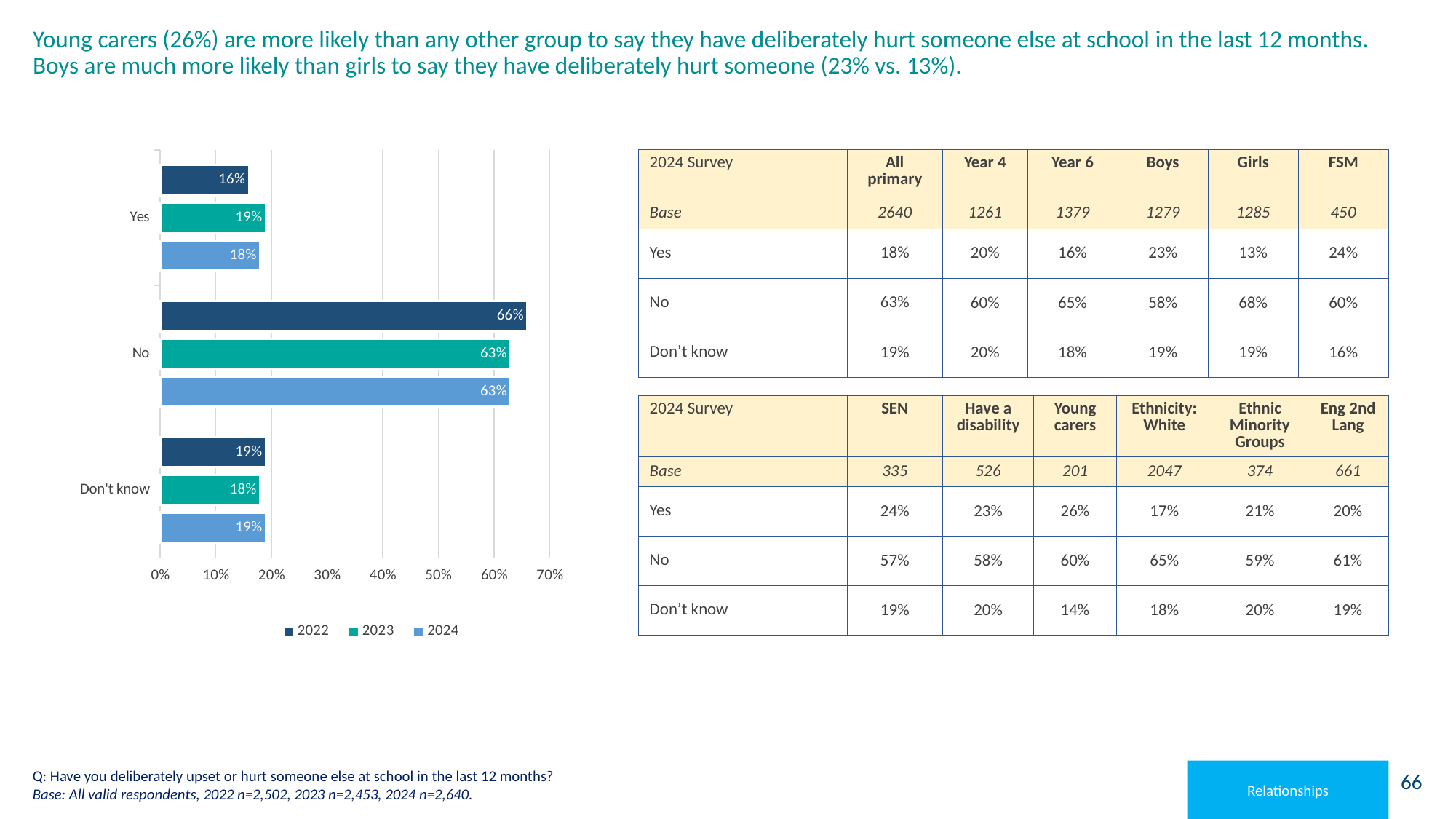
What kind of chart is shown on the slide? bar chart What is the value for 'Yes' in the 2024 series? 18% How many series does the legend list? 3 What is the value for 'No' in the 2022 series? 66% Which category has the highest value in the 2024 series? No What is the value for 'Don't know' in the 2023 series? 18% Which category has the lowest value in the 2022 series? Yes Which series is shown in the darkest blue colour in the legend? 2022 How many categories are shown on the chart? 3 Is the value for 'No' in 2023 greater or less than 50%? greater Which is larger: the 2023 value for 'Yes' or the 2022 value for 'Yes'? 2023 What is the difference between the 2022 and 2024 values for 'No'? 3%